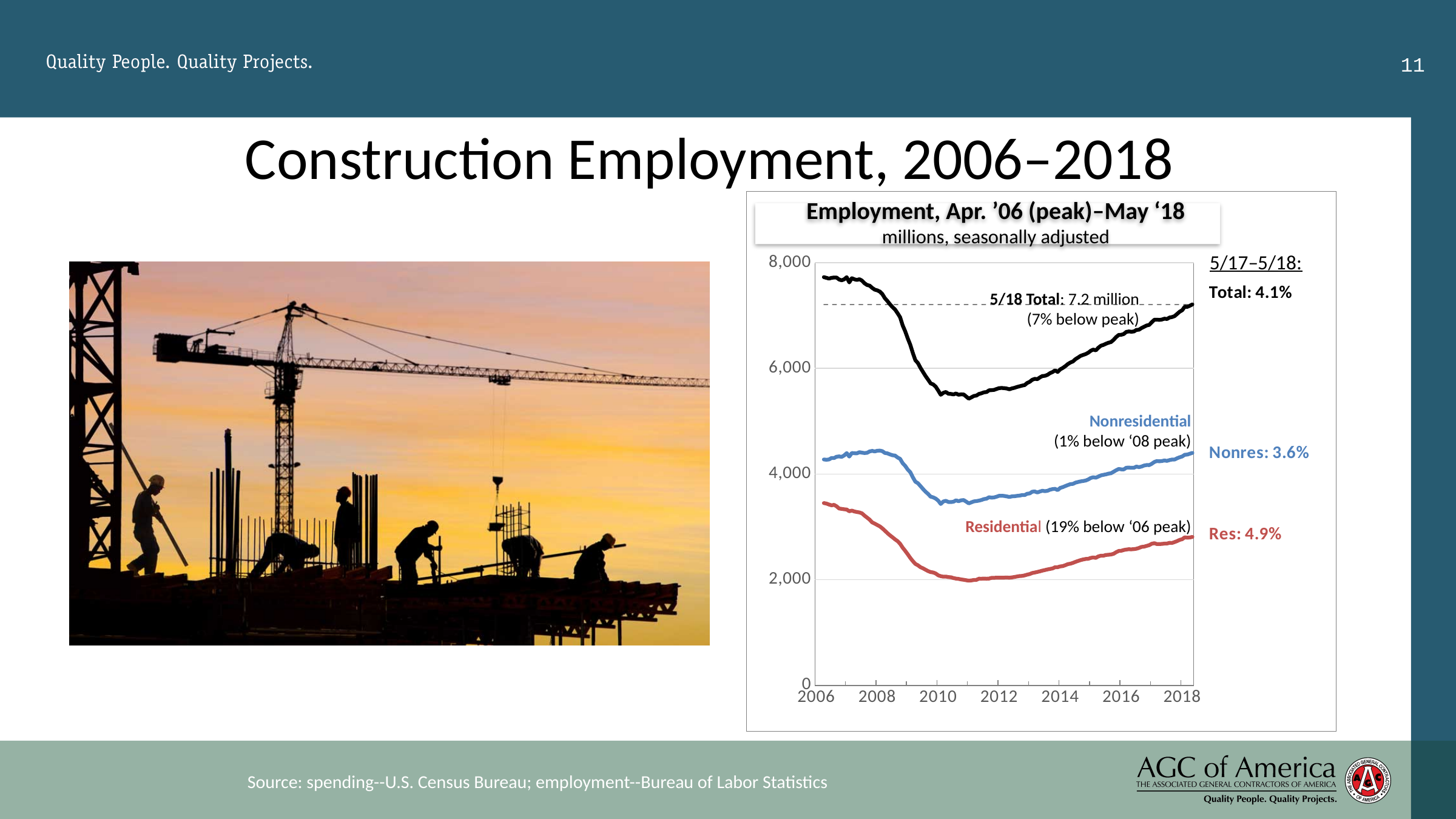
How many lines (series) are plotted on the chart? 4 What is the 5/17–5/18 change for Residential (Res) employment? 4.9% By what percentage is the 5/18 Total below its peak, according to the chart? 7% By what percentage is Nonresidential employment below its '08 peak? 1% Does the Total line rise or fall between 2006 and 2010? fall What is the 5/17–5/18 change for Total employment? 4.1% What is the 5/18 Total employment value labelled on the chart? 7.2 million Is the Residential line in 2018 greater or less than 4,000? less What kind of chart is shown on the slide? line chart What is the title of the chart? Employment, Apr. '06 (peak)–May '18 By what percentage is Residential employment below its '06 peak? 19% Which grew faster from 5/17 to 5/18, Nonres or Res? Res